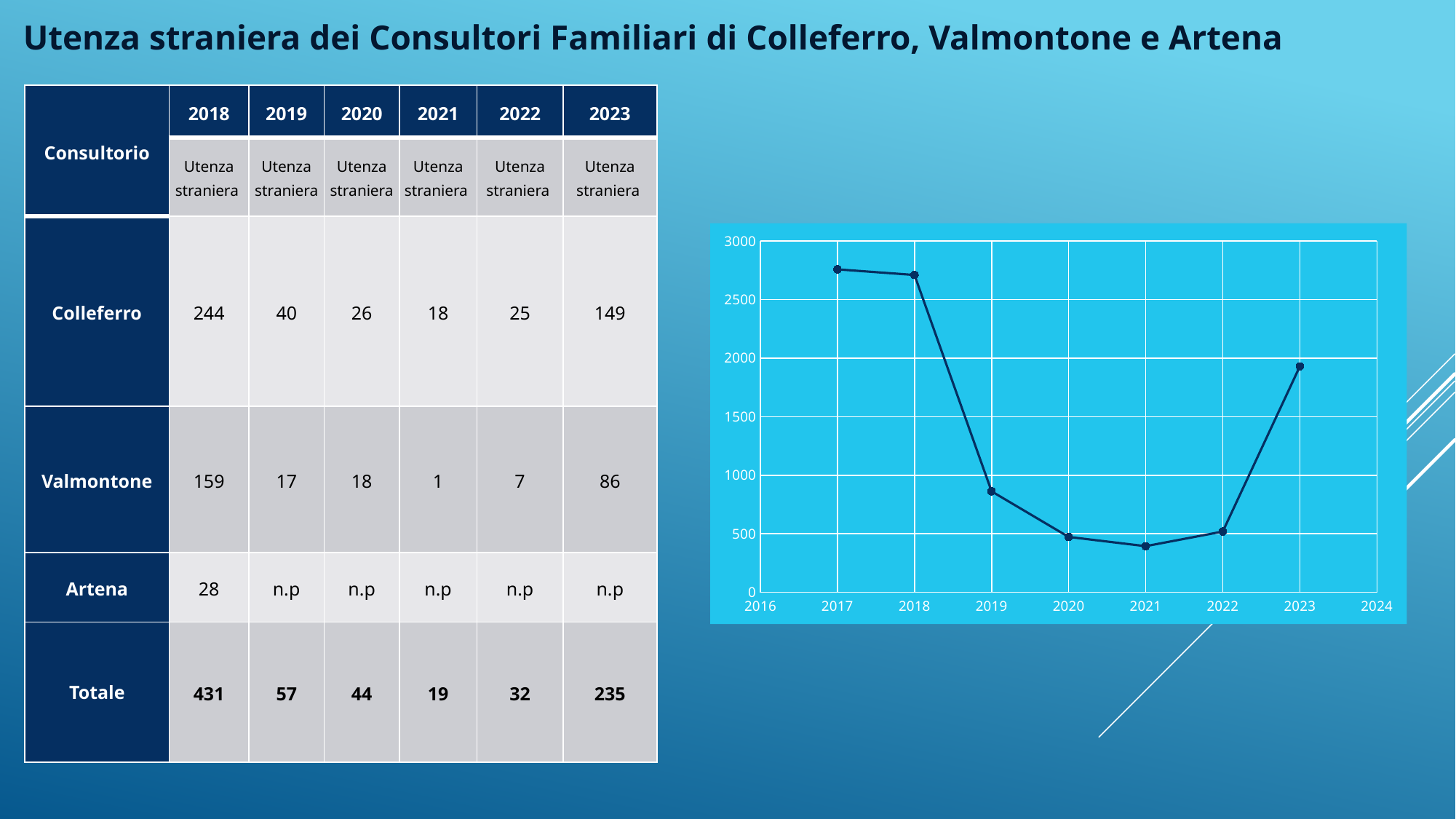
On the line chart, do the values rise or fall from 2018 to 2021? fall On the line chart, which is larger, the value for 2019 or the value for 2023? 2023 On the line chart, is the value for 2017 greater or less than 2500? greater What kind of chart is shown on the right side of the slide? line chart What is the highest value shown on the vertical axis of the line chart? 3000 On the line chart, is the value for 2021 greater or less than 500? less On the line chart, is the value for 2019 greater or less than 1000? less On the line chart, do the values rise or fall from 2021 to 2023? rise How many data points are plotted on the line chart? 7 On the line chart, which is larger, the value for 2017 or the value for 2020? 2017